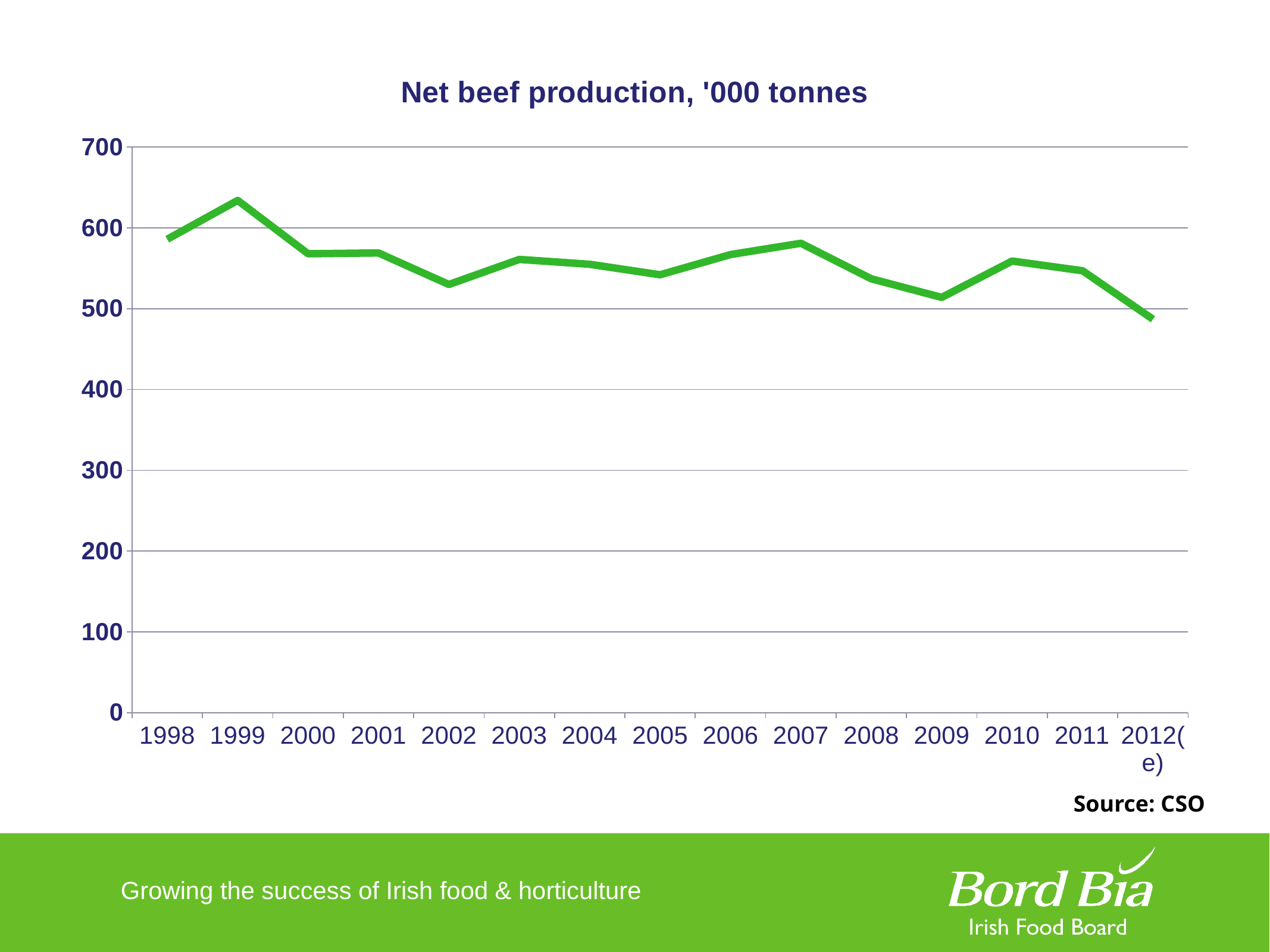
Which year has the lowest net beef production? 2012(e) Which is larger, the value for 1999 or the value for 2002? 1999 Overall, does net beef production rise or fall from 1998 to 2012(e)? fall Which year has the highest net beef production? 1999 What is the title of the chart? Net beef production, '000 tonnes What kind of chart is shown on the slide? line chart Is the value for 2002 greater or less than 500? greater How many years are plotted on the x axis? 15 Is the value for 1999 greater or less than 600? greater Is the value for 2007 greater or less than 600? less Which is larger, the value for 2007 or the value for 2009? 2007